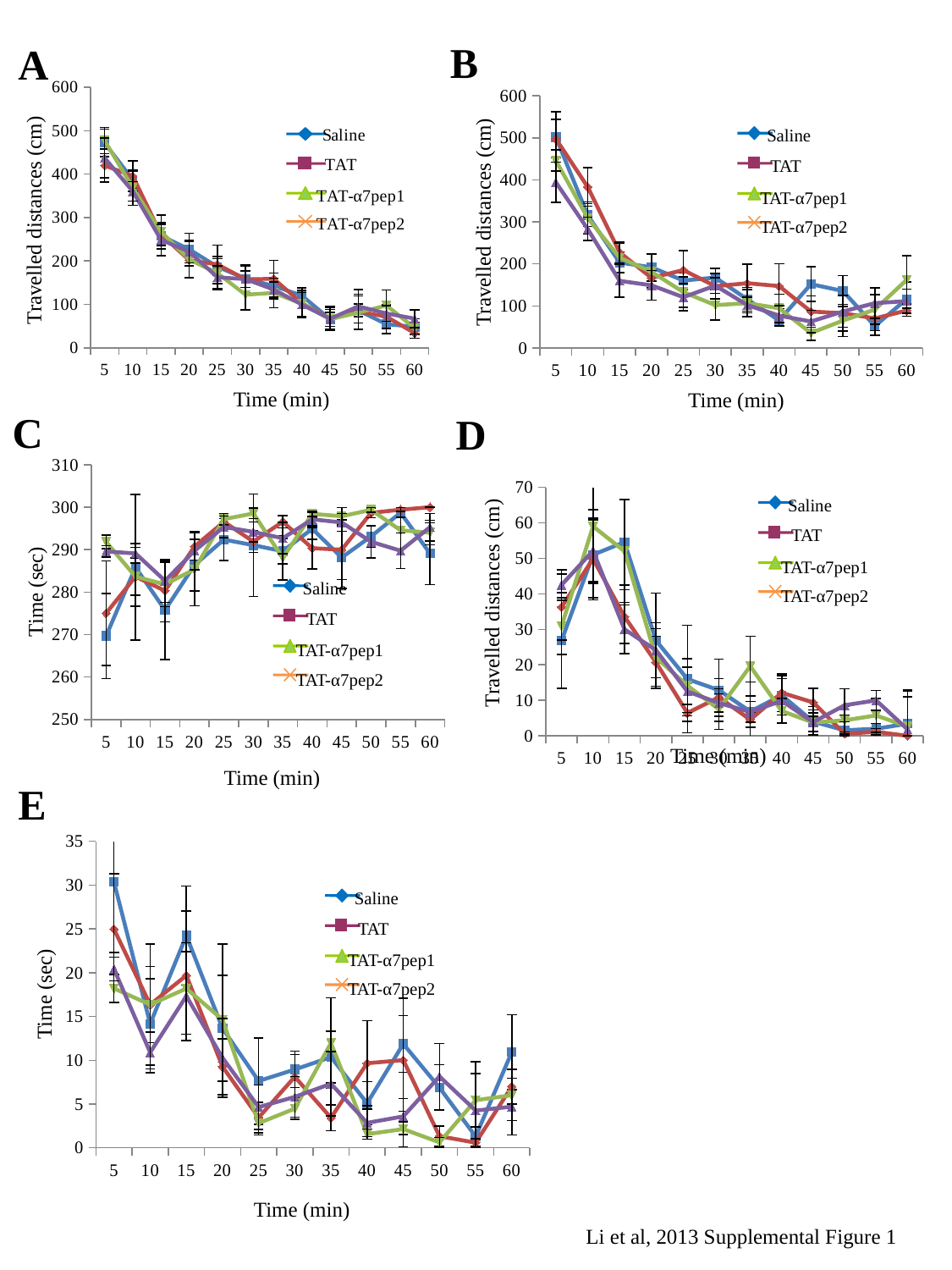
In chart E, is the Saline value at 5 min greater or less than 25? greater In chart B, is the Saline value at 5 min greater or less than 400? greater What kind of chart is chart A? line chart What is the y-axis title of chart C? Time (sec) In chart A, do the travelled distances generally rise or fall as time increases from 5 to 60 min? fall How many time points are plotted along the x axis of chart E? 12 How many series does the legend of chart B list? 4 In chart C, is the Saline value at 5 min greater or less than 280? less What is the x-axis title of chart A? Time (min)